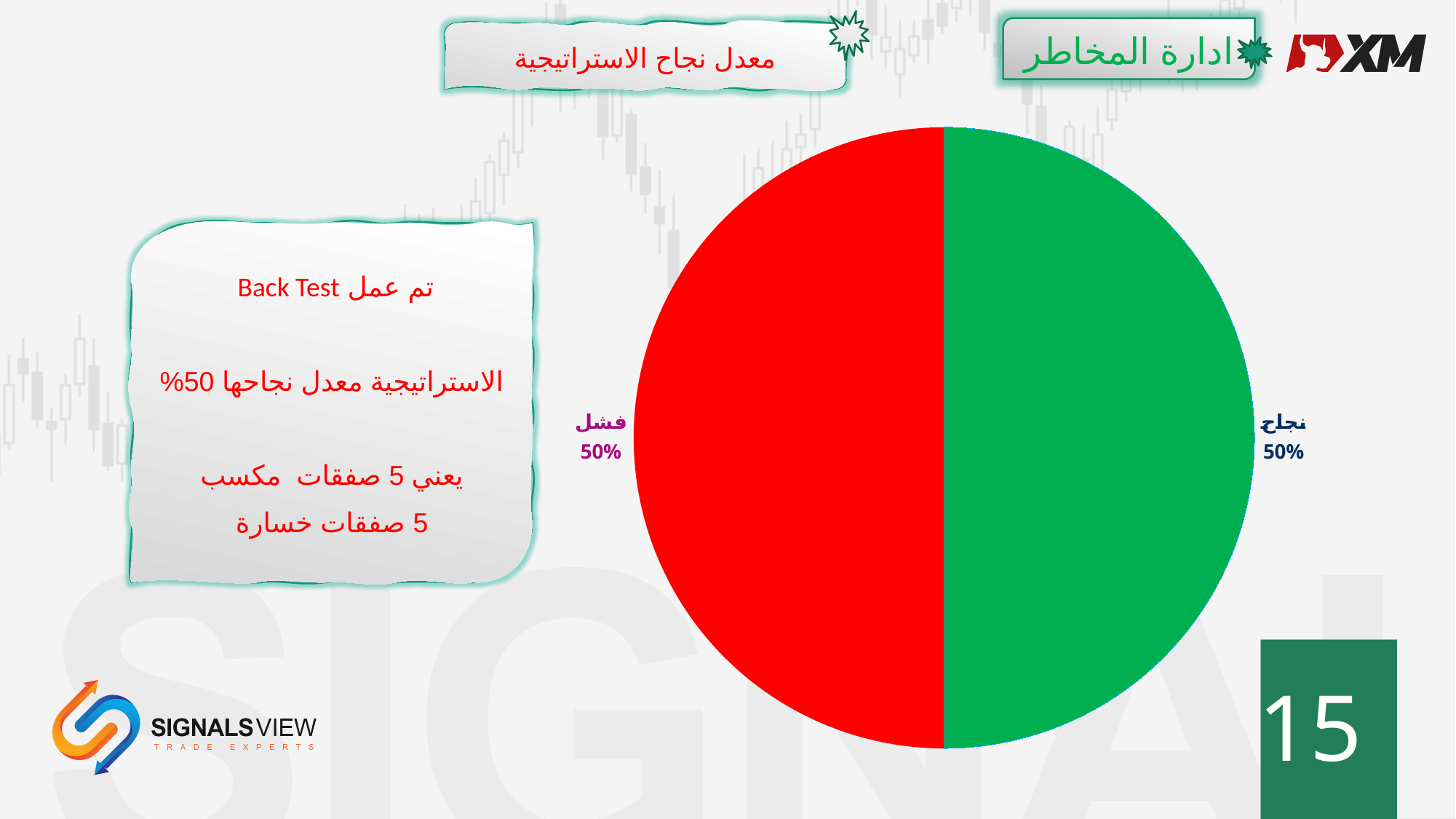
What is the value shown for the فشل slice? 50% What colour is the فشل slice? red What share of the pie does the نجاح slice represent? 50% What kind of chart is shown on the slide? pie chart What share of the pie does the فشل slice represent? 50% What colour is the نجاح slice? green What is the difference between the نجاح and فشل values? 0% How many slices does the pie chart have? 2 What is the value shown for the نجاح slice? 50%